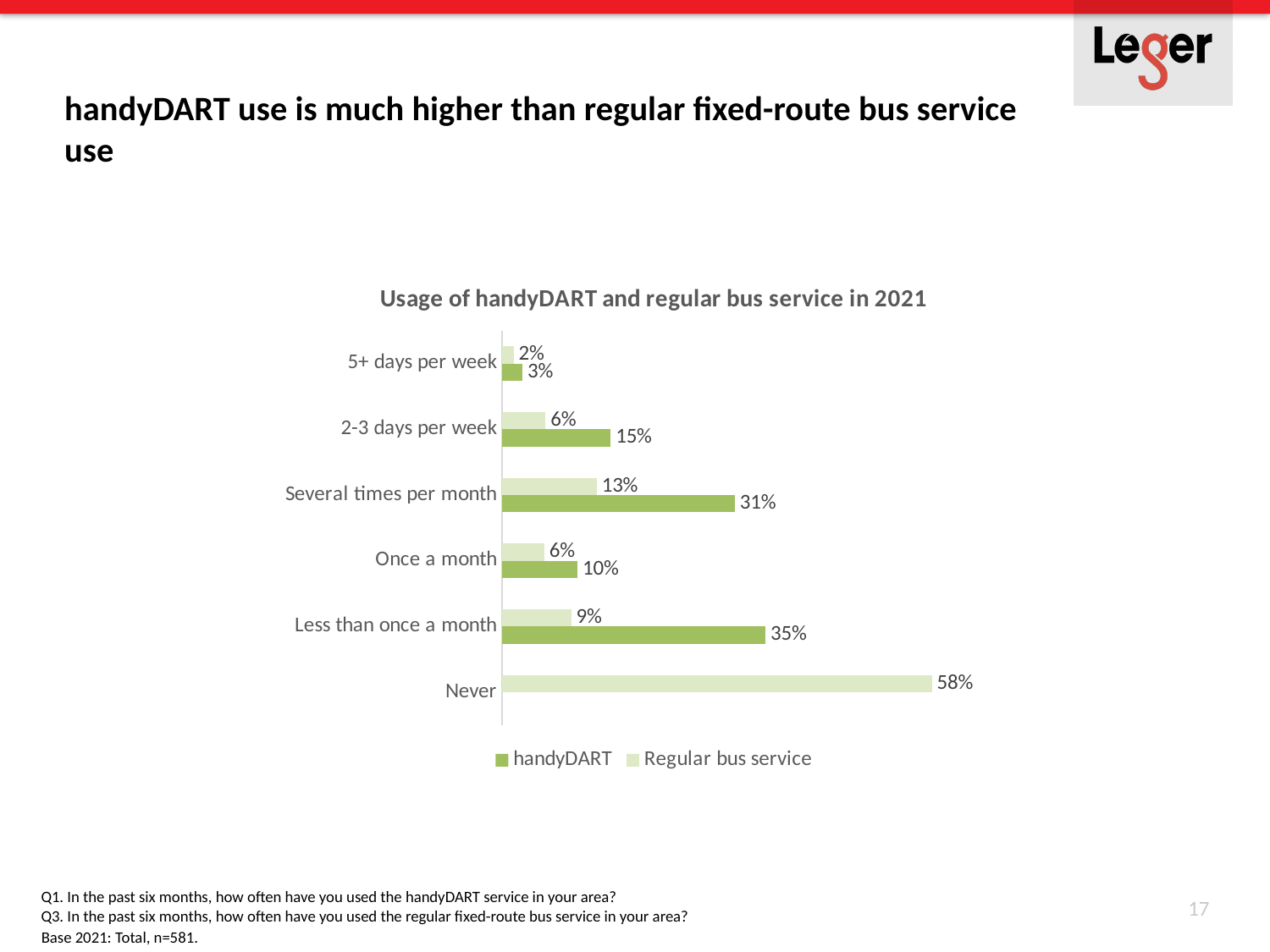
What kind of chart is shown on the slide? Bar chart Which category has the lowest Regular bus service value? 5+ days per week Which category has the highest handyDART value? Less than once a month Which is larger for 'Once a month': the handyDART value or the Regular bus service value? handyDART What is the handyDART value for '2-3 days per week'? 15% What is the title of the chart? Usage of handyDART and regular bus service in 2021 What is the handyDART value for 'Several times per month'? 31% What is the difference between the handyDART and Regular bus service values for 'Less than once a month'? 26% What is the Regular bus service value for 'Less than once a month'? 9% How many series does the legend list? 2 How many usage categories are shown on the chart? 6 What is the Regular bus service value for 'Never'? 58%